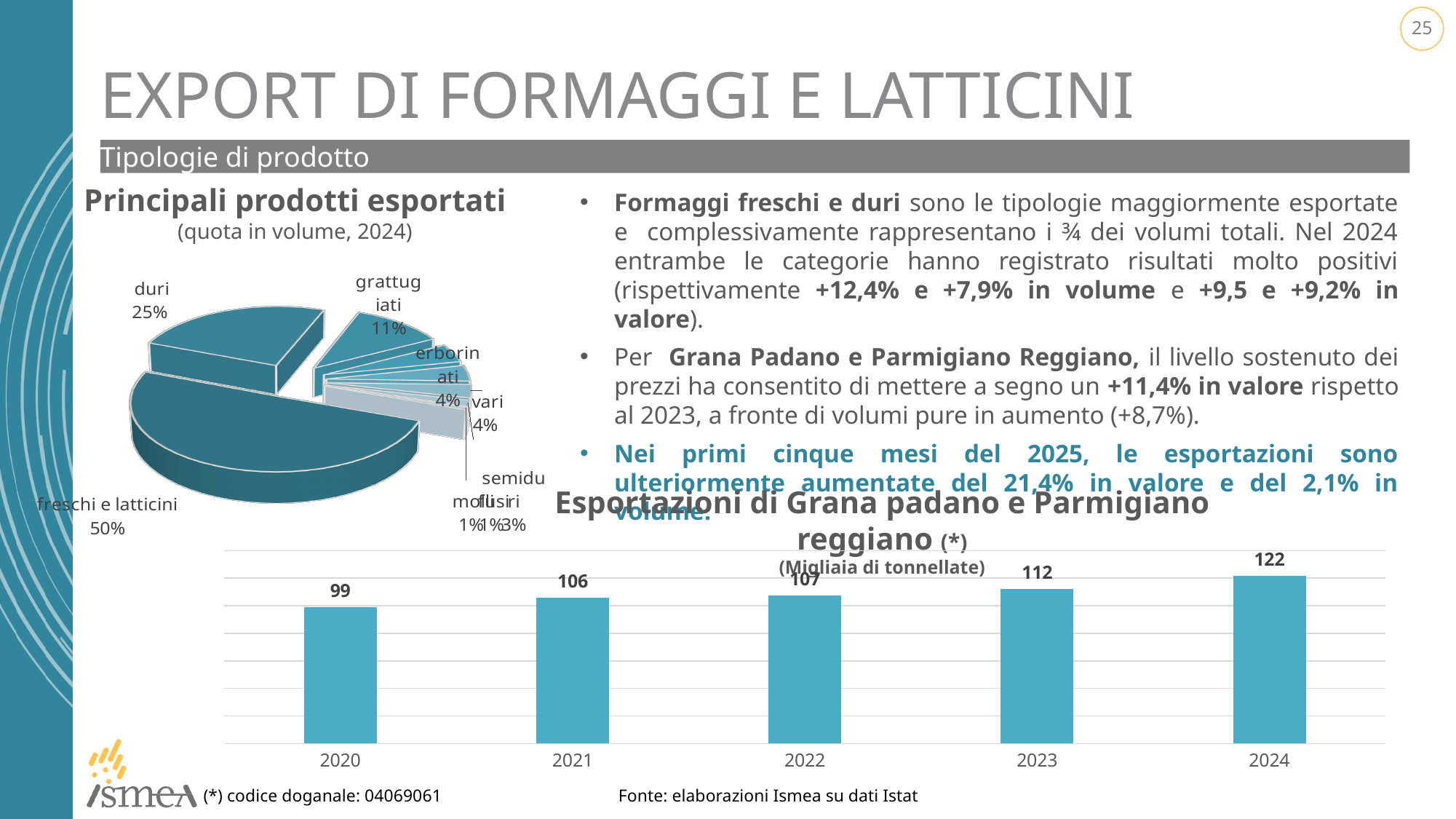
In the bar chart 'Esportazioni di Grana padano e Parmigiano reggiano', how many years are shown? 5 In the pie chart 'Principali prodotti esportati', which is larger: 'grattugiati' or 'erborinati'? grattugiati In the bar chart 'Esportazioni di Grana padano e Parmigiano reggiano', what is the value for 2024? 122 In the pie chart 'Principali prodotti esportati', what share does 'duri' have? 25% In the pie chart 'Principali prodotti esportati', which category has the largest slice? freschi e latticini In the pie chart 'Principali prodotti esportati', what share does 'freschi e latticini' have? 50% In the bar chart 'Esportazioni di Grana padano e Parmigiano reggiano', what is the difference between the 2024 and 2023 values? 10 In the bar chart 'Esportazioni di Grana padano e Parmigiano reggiano', which year has the lowest value? 2020 In the bar chart 'Esportazioni di Grana padano e Parmigiano reggiano', what is the value for 2020? 99 In the bar chart 'Esportazioni di Grana padano e Parmigiano reggiano', which year has the highest value? 2024 In the bar chart 'Esportazioni di Grana padano e Parmigiano reggiano', do the values rise or fall from 2020 to 2024? rise What kind of chart is 'Esportazioni di Grana padano e Parmigiano reggiano'? bar chart